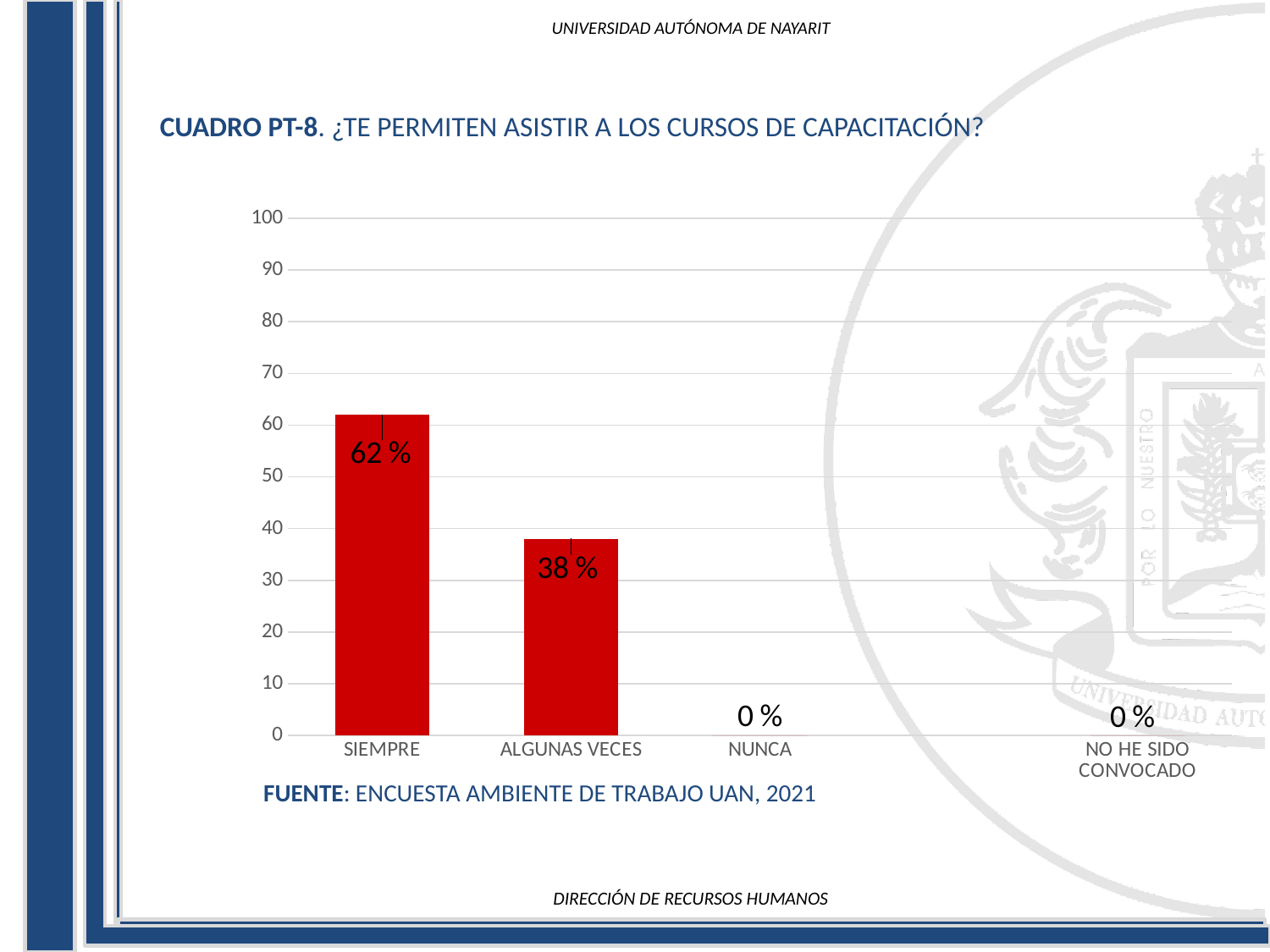
Is the value for SIEMPRE greater or less than 50? greater Is the value for ALGUNAS VECES greater or less than 40? less How many categories are shown on the x axis? 4 What kind of chart is shown on the slide? Bar chart What is the difference between the values for SIEMPRE and ALGUNAS VECES? 24 % Which is larger, the value for SIEMPRE or the value for ALGUNAS VECES? SIEMPRE Which category has the highest value? SIEMPRE What is the value for NUNCA? 0 % What is the value for NO HE SIDO CONVOCADO? 0 % What is the value for SIEMPRE? 62 % What is the value for ALGUNAS VECES? 38 % What is the source cited below the chart? ENCUESTA AMBIENTE DE TRABAJO UAN, 2021